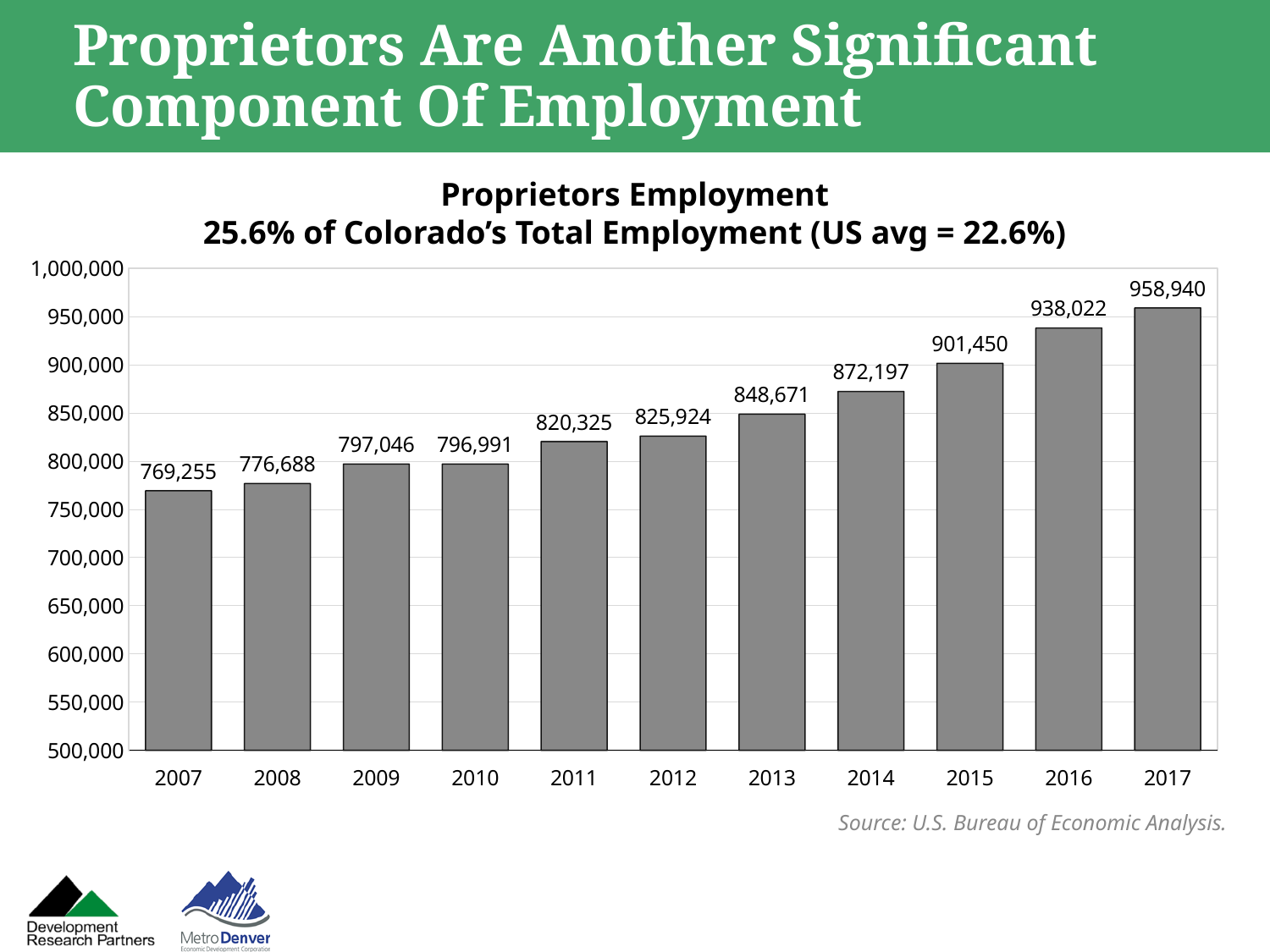
What is the proprietors employment value for 2017? 958,940 According to the chart subtitle, what share of Colorado's total employment is proprietors employment? 25.6% Is the proprietors employment value for 2013 greater or less than 850,000? less What is the difference in proprietors employment between 2017 and 2016? 20,918 What is the difference in proprietors employment between 2015 and 2014? 29,253 What kind of chart is shown on the slide? bar chart What is the proprietors employment value for 2012? 825,924 Which year has the larger proprietors employment, 2009 or 2010? 2009 What is the proprietors employment value for 2007? 769,255 Which year has the lowest proprietors employment? 2007 Which year has the highest proprietors employment? 2017 How many years are shown on the x axis of the chart? 11